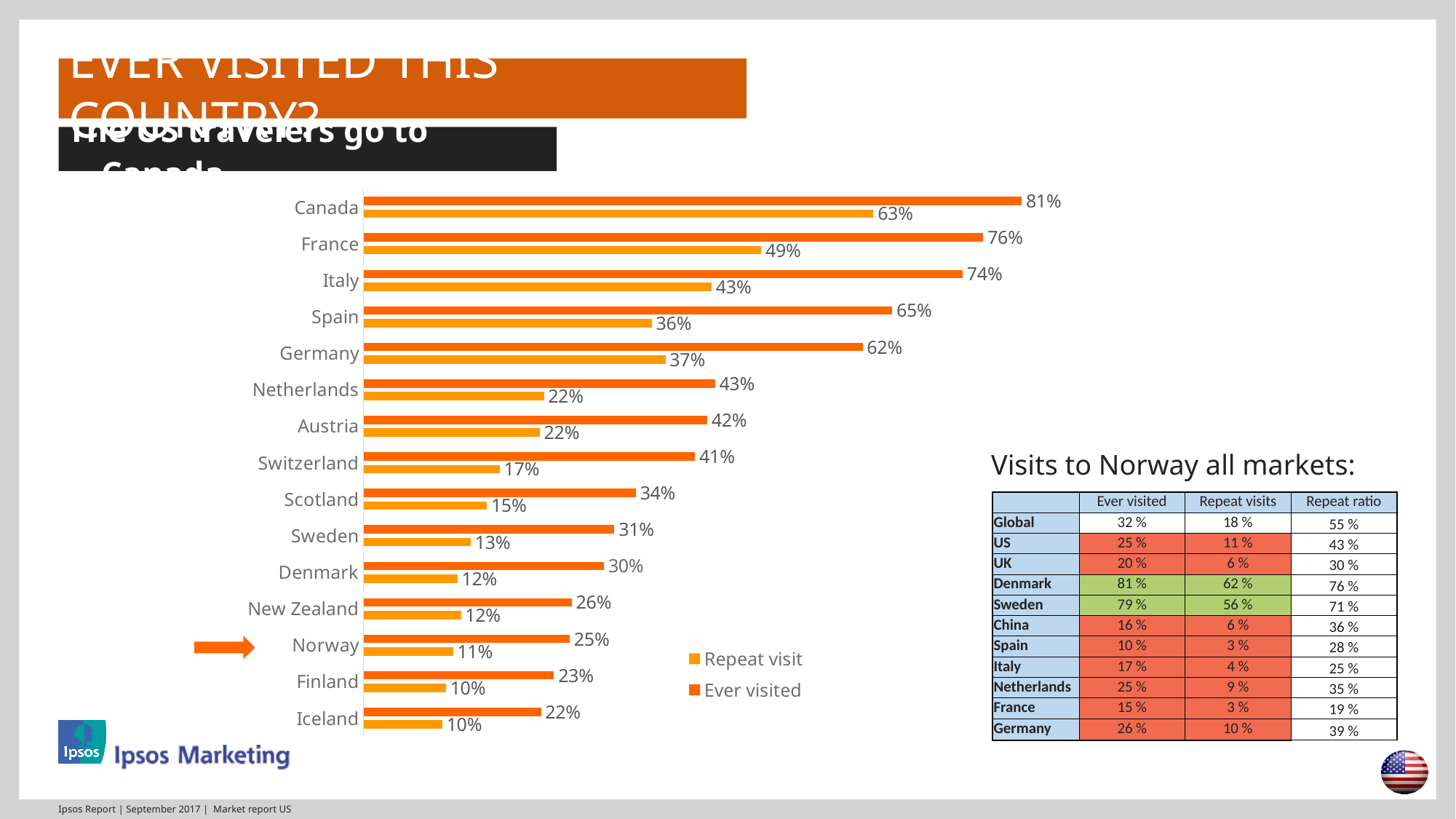
What is the difference between the 'Ever visited' and 'Repeat visit' values for Italy? 31% What is the 'Ever visited' value for Canada? 81% How many series does the chart legend list? 2 Do the 'Ever visited' values rise or fall going down the list from Canada to Iceland? Fall What kind of chart is shown on the slide? Bar chart How many countries are shown in the bar chart? 15 What is the 'Repeat visit' value for Norway? 11% Which series is shown in the darker orange colour in the chart? Ever visited What is the 'Repeat visit' value for France? 49% Which country has the lowest 'Ever visited' value? Iceland Which is larger: the 'Ever visited' value for Spain or for Germany? Spain Which country has the highest 'Ever visited' value? Canada